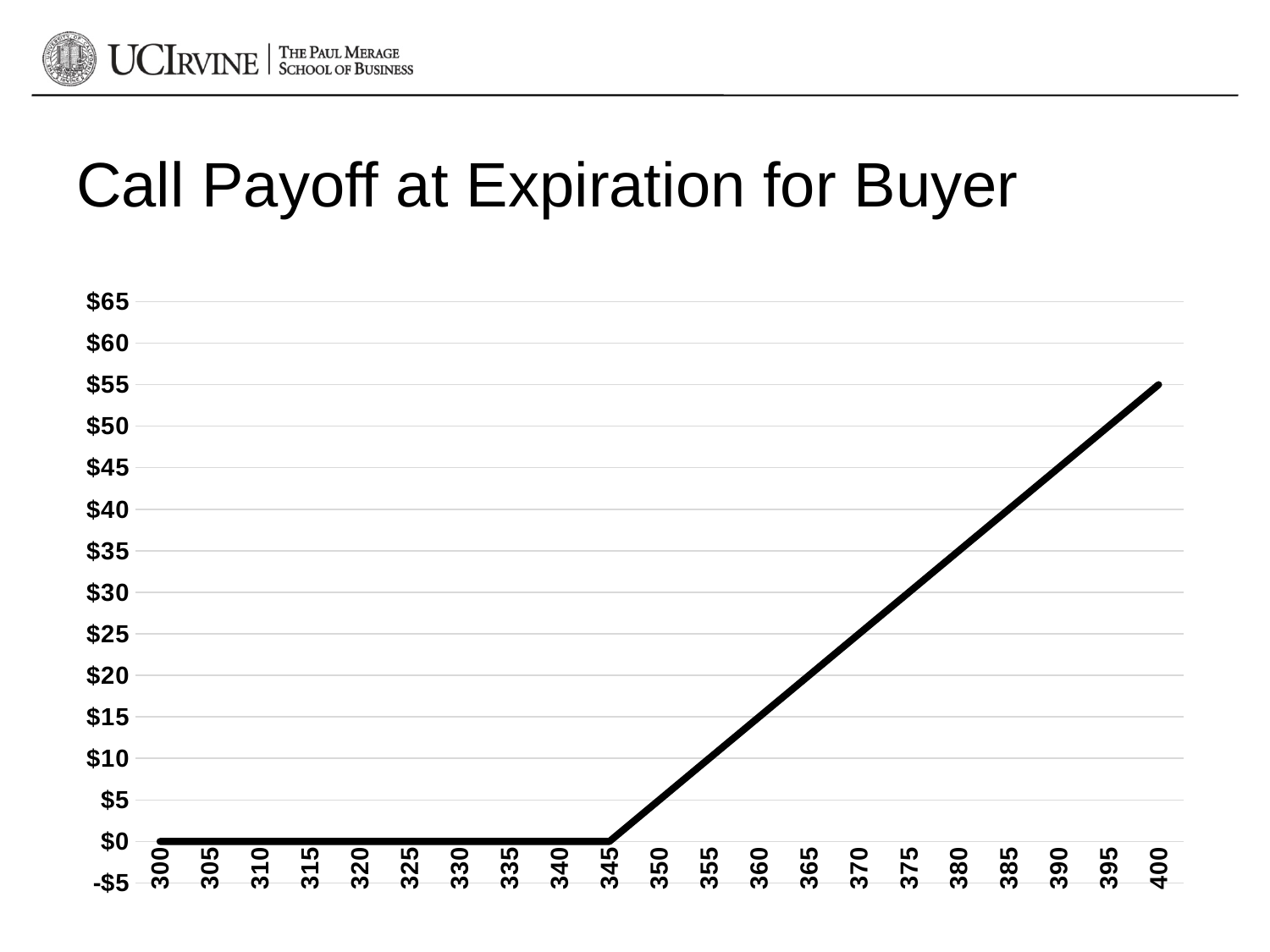
What is the payoff value at a price of 345? $0 Is the payoff at a price of 360 greater or less than $20? less Is the payoff at a price of 380 greater or less than $30? greater What is the title of the chart? Call Payoff at Expiration for Buyer Does the payoff rise or fall as the price moves from 345 to 400? rise What is the payoff value at a price of 400? $55 Which has the larger payoff, a price of 390 or a price of 360? 390 What is the difference between the payoff at 400 and the payoff at 345? $55 At which price on the x axis is the payoff highest? 400 What is the payoff value at a price of 300? $0 How many price points are labelled on the x axis? 21 What kind of chart is shown on the slide? line chart